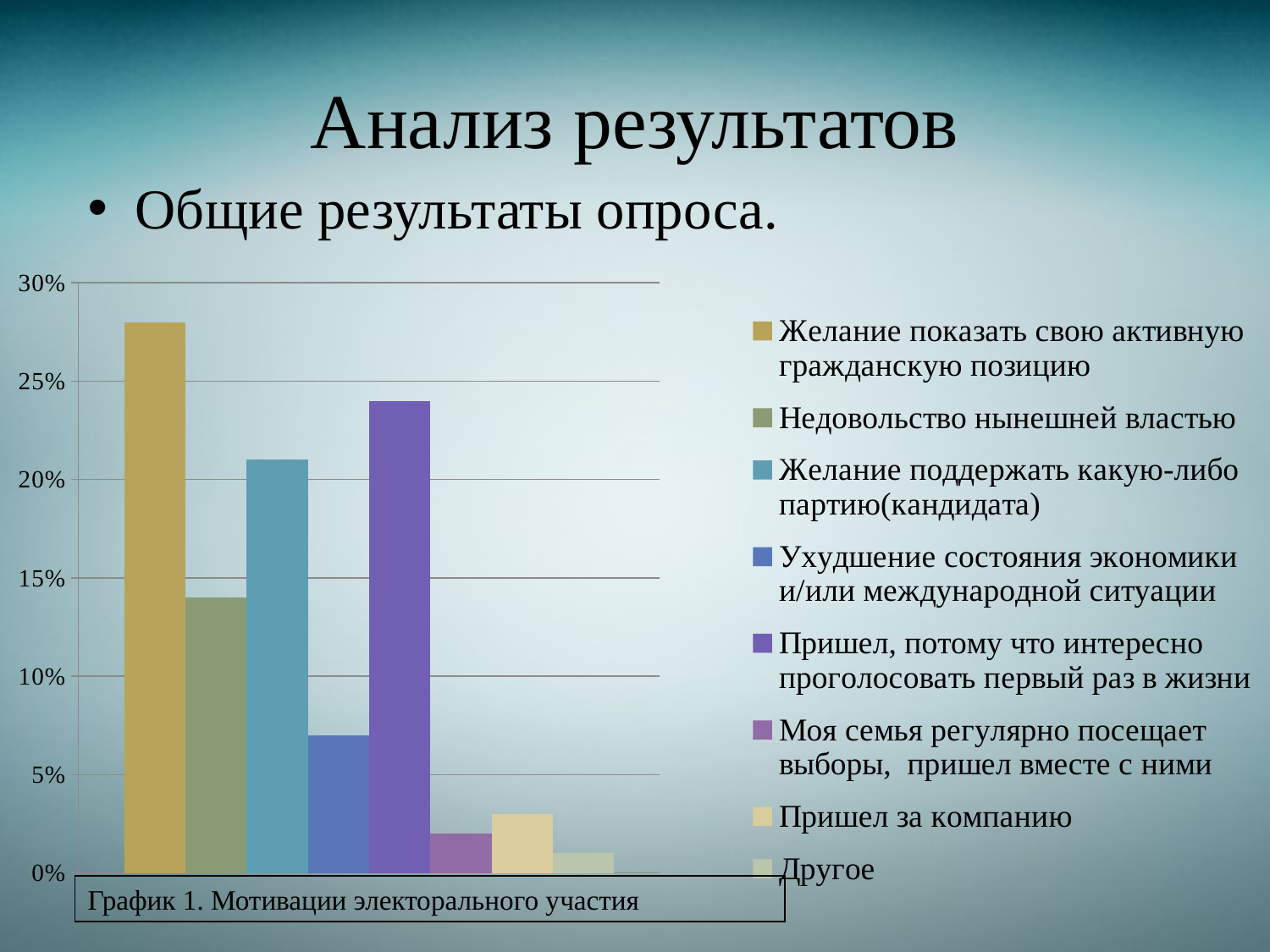
How many series does the legend list? 8 What kind of chart is shown on the slide? bar chart Is the value for 'Недовольство нынешней властью' greater or less than 15%? less Which is larger: the value for 'Желание поддержать какую-либо партию(кандидата)' or for 'Пришел, потому что интересно проголосовать первый раз в жизни'? Пришел, потому что интересно проголосовать первый раз в жизни Is the value for 'Ухудшение состояния экономики и/или международной ситуации' greater or less than 10%? less Which series has the lowest value in the chart? Другое Is the value for 'Желание показать свою активную гражданскую позицию' greater or less than 25%? greater Which series has the highest value in the chart? Желание показать свою активную гражданскую позицию Which is larger: the value for 'Недовольство нынешней властью' or for 'Ухудшение состояния экономики и/или международной ситуации'? Недовольство нынешней властью What is the caption printed below the chart? График 1. Мотивации электорального участия How many bars are plotted in the chart? 8